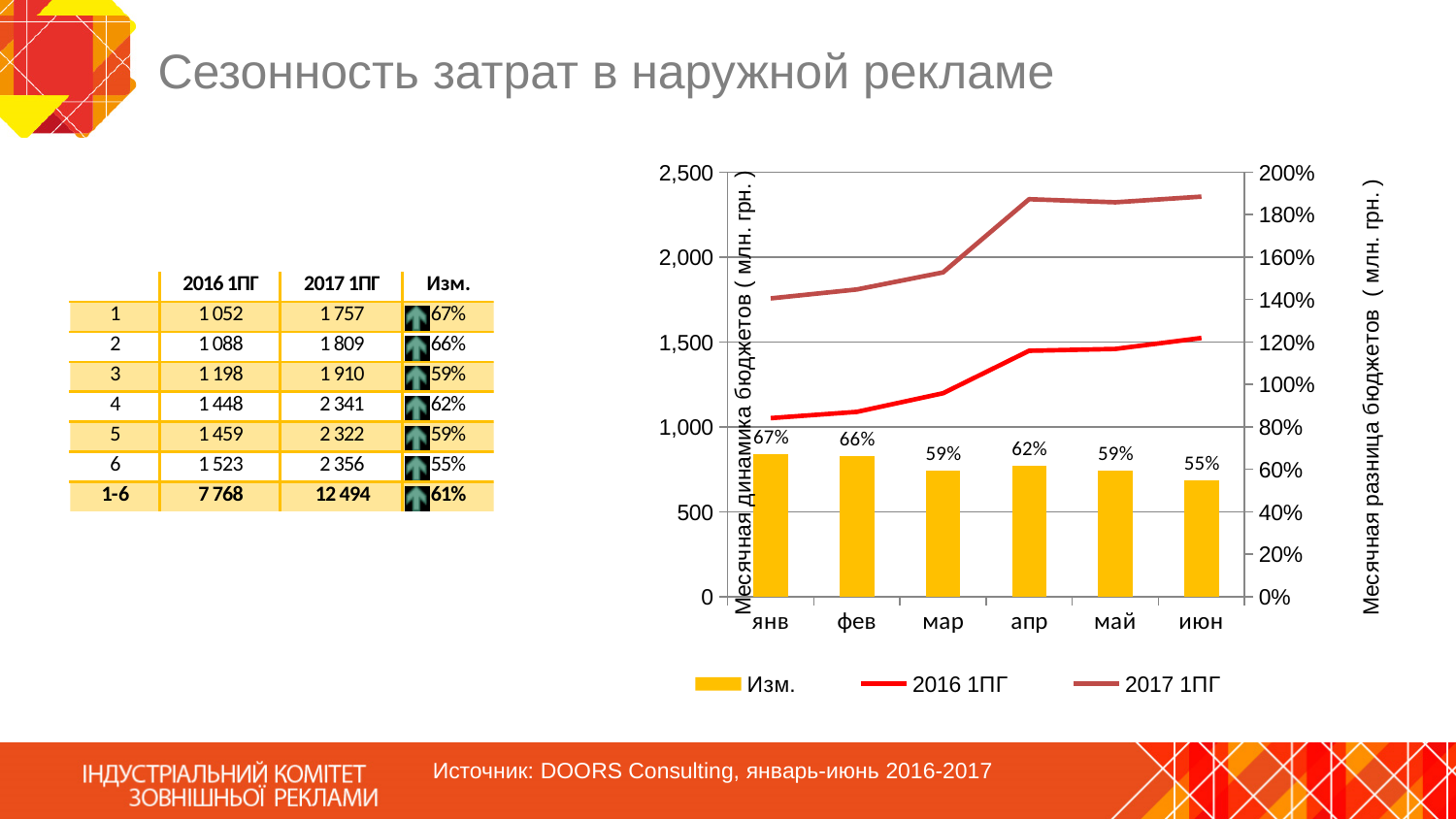
Is the value of the 2017 1ПГ line for апр greater or less than 2,000? greater What is the value of the Изм. bar for янв? 67% Which has the larger Изм. value, мар or апр? апр Does the 2017 1ПГ line rise or fall from янв to апр? rises Is the value of the 2016 1ПГ line for янв greater or less than 1,500? less Which month has the highest Изм. bar? янв How many series does the chart legend list? 3 What is the difference between the Изм. values for янв and июн? 12% What is the value of the Изм. bar for июн? 55% What is the value of the Изм. bar for апр? 62% How many months are shown on the x axis of the chart? 6 Which month has the lowest Изм. bar? июн